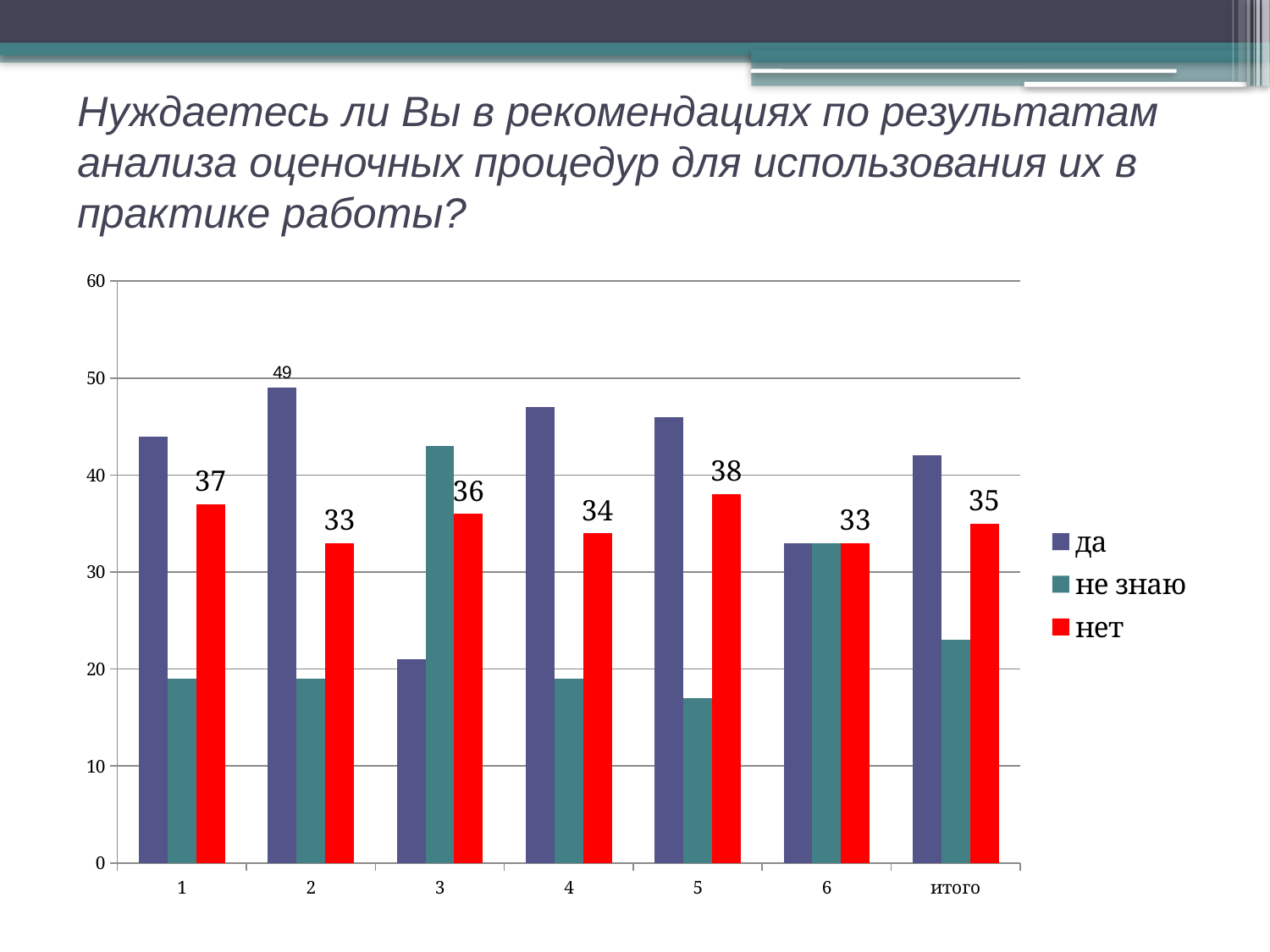
What is the value of the "нет" series for category 1? 37 What is the value of the "да" series for category 2? 49 What kind of chart is shown on the slide? bar chart Is the value of the "не знаю" series for category 3 greater or less than 40? greater What are the entries in the chart legend? да, не знаю, нет Which category has the highest value in the "нет" series? 5 How many categories are shown on the x axis? 7 What is the difference between the "нет" values for category 5 and category 2? 5 How many series does the legend list? 3 What is the value of the "нет" series for "итого"? 35 Is the value of the "да" series for category 3 greater or less than 30? less Which is larger: the "нет" value for category 1 or for category 3? category 1